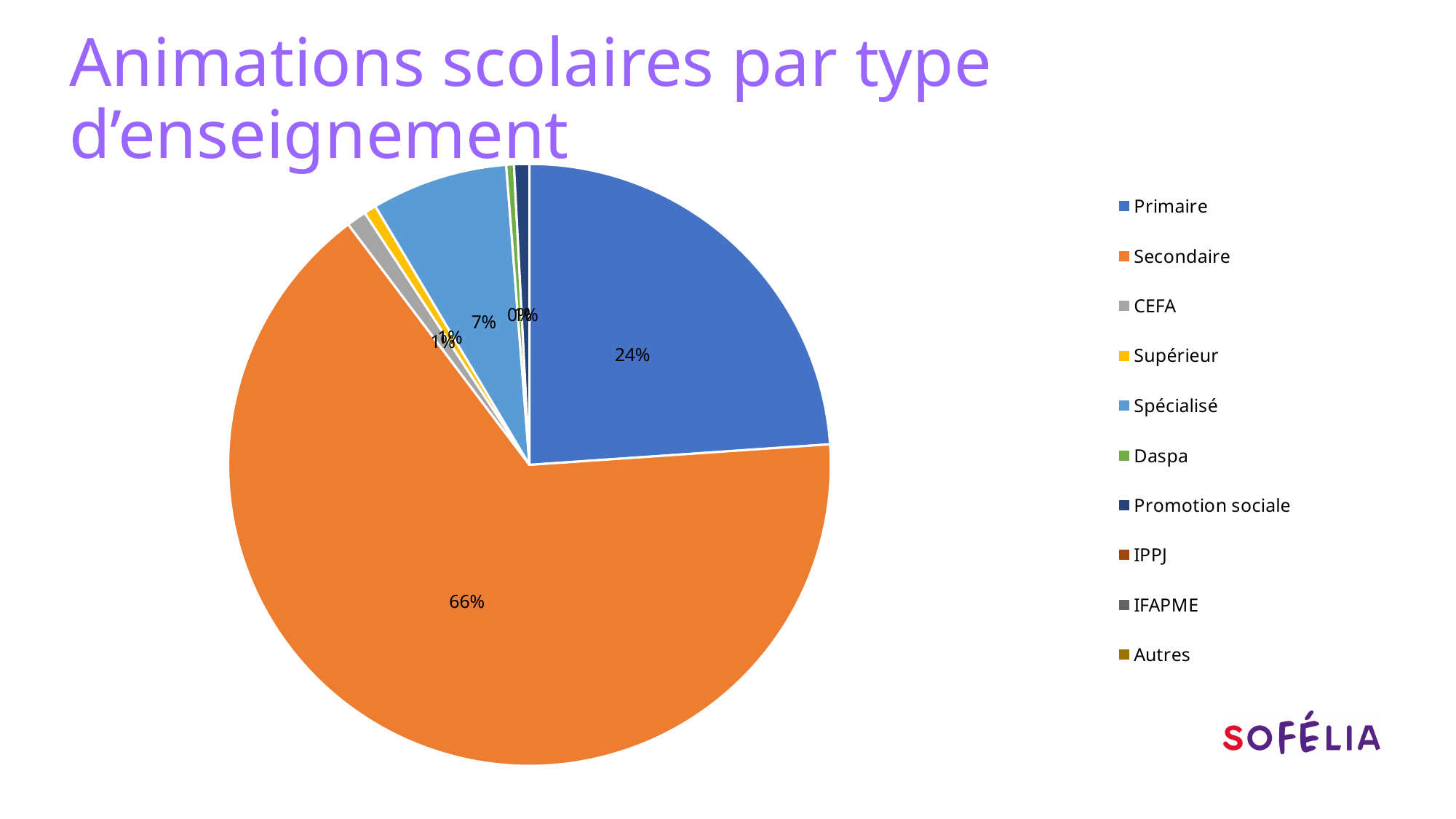
What is the combined share of the Primaire and Secondaire slices? 90% Which type of enseignement has the largest slice of the pie? Secondaire What is the title of the slide? Animations scolaires par type d'enseignement Which is larger, the slice for Secondaire or the slice for Primaire? Secondaire What is the difference in percentage points between the Secondaire slice and the Primaire slice? 42 percentage points What share of the pie does Secondaire represent? 66% What colour is the Secondaire slice in the pie chart? Orange Which is larger, the slice for Primaire or the slice for Spécialisé? Primaire What share of the pie does Primaire represent? 24% How many entries does the legend list? 10 What kind of chart is shown on the slide? Pie chart What share of the pie does Spécialisé represent? 7%